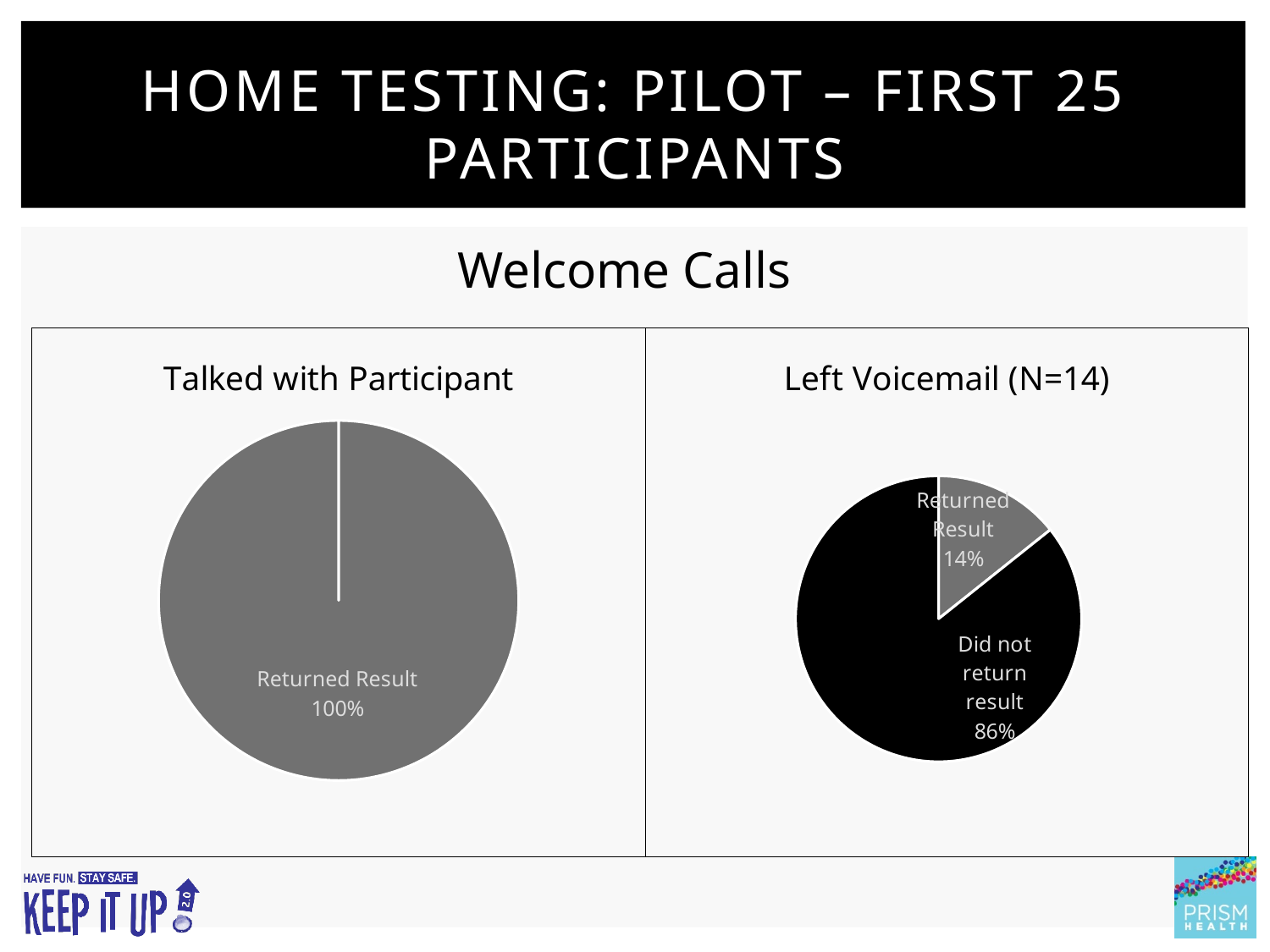
How many slices does the 'Talked with Participant' chart have? 1 In the 'Left Voicemail (N=14)' chart, which slice is the largest? Did not return result What is the title of the chart on the right side of the slide? Left Voicemail (N=14) What is the heading above the two charts? Welcome Calls In the 'Left Voicemail (N=14)' chart, which is larger: 'Returned Result' or 'Did not return result'? Did not return result In the 'Left Voicemail (N=14)' chart, what share of the pie is 'Returned Result'? 14% In the 'Left Voicemail (N=14)' chart, which slice is the smallest? Returned Result What kind of chart is the 'Talked with Participant' chart? Pie chart In the 'Left Voicemail (N=14)' chart, what is the difference between the 'Did not return result' share and the 'Returned Result' share? 72% How many slices does the 'Left Voicemail (N=14)' chart have? 2 In the 'Left Voicemail (N=14)' chart, what share of the pie is 'Did not return result'? 86% In the 'Talked with Participant' chart, what share of the pie is 'Returned Result'? 100%